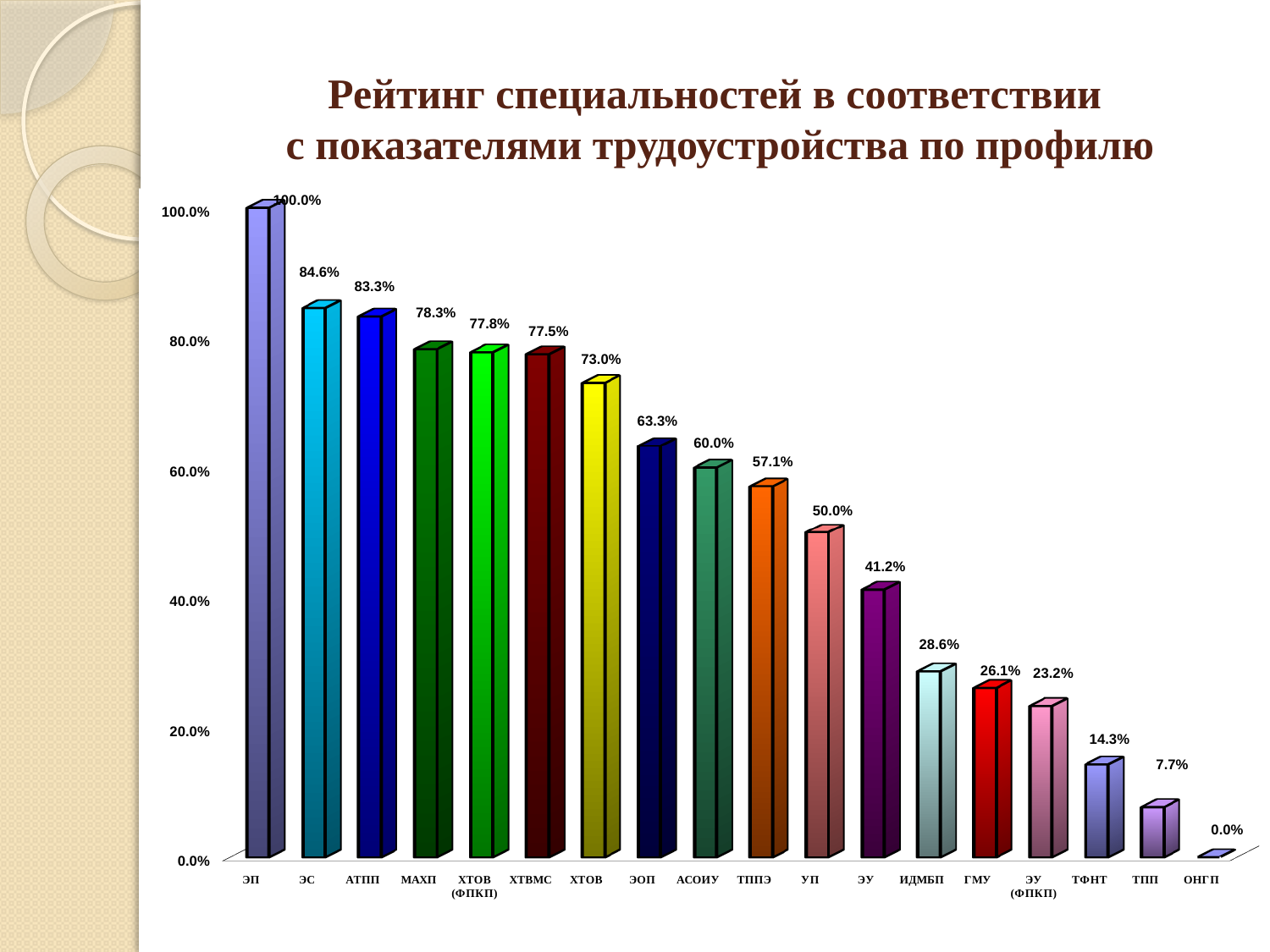
Which category has the highest value? ЭП Which is larger, the value for ЭОП or the value for ТППЭ? ЭОП What is the difference between the values for ЭУ and ГМУ? 15.1% Which category has the lowest value? ОНГП What is the value for ЭС? 84.6% What is the value for ТФНТ? 14.3% What is the value for ИДМБП? 28.6% What is the difference between the values for АТПП and МАХП? 5.0% What kind of chart is shown on the slide? bar chart Is the value for ХТОВ greater or less than 60.0%? greater How many categories are shown on the x axis? 18 What is the value for УП? 50.0%